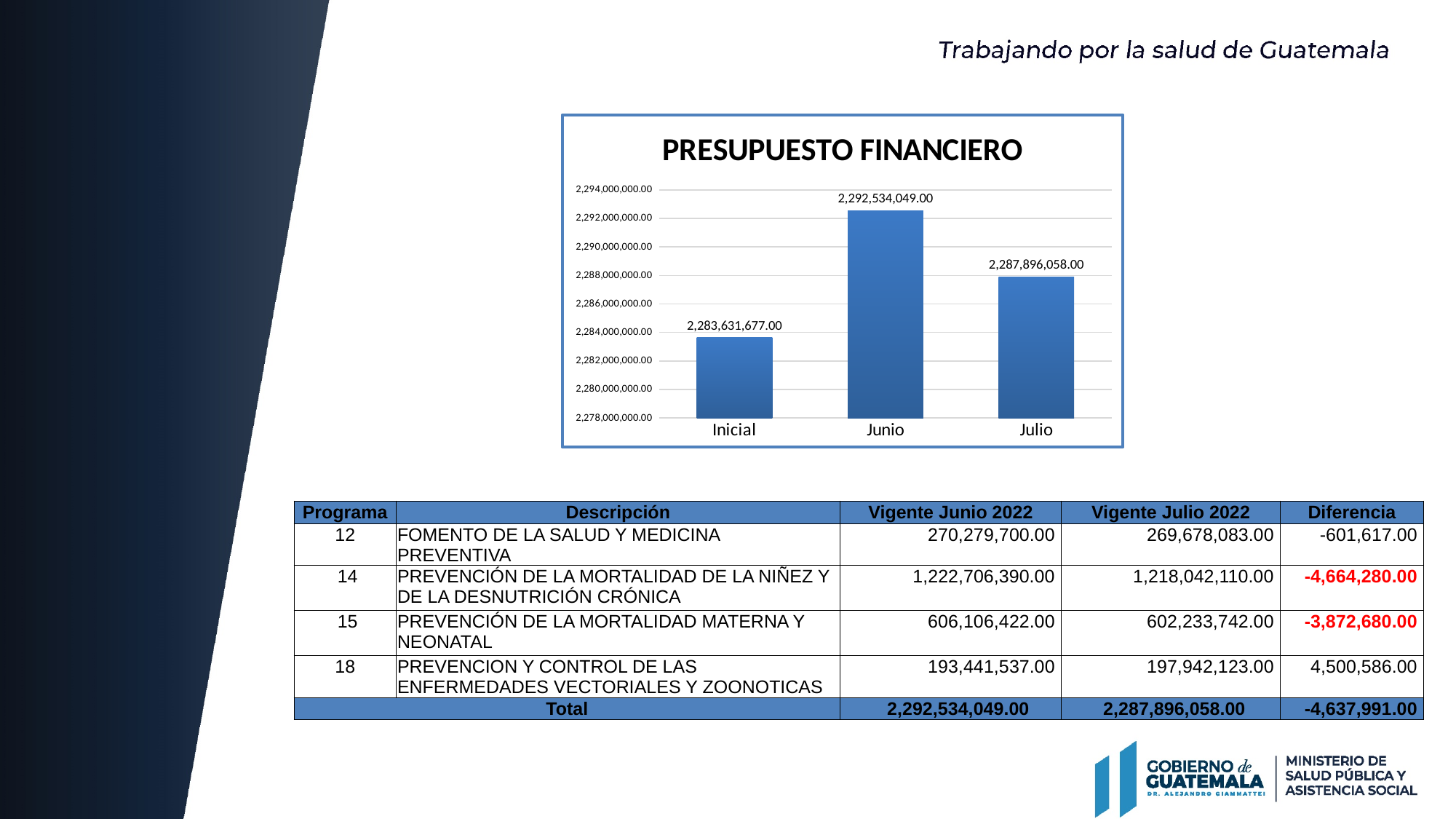
How many bars are shown in the PRESUPUESTO FINANCIERO chart? 3 In the PRESUPUESTO FINANCIERO chart, which is larger, the value for Julio or the value for Inicial? Julio What is the value for Inicial in the PRESUPUESTO FINANCIERO chart? 2,283,631,677.00 What is the difference between the Junio and Inicial values in the PRESUPUESTO FINANCIERO chart? 8,902,372.00 Which category has the lowest value in the PRESUPUESTO FINANCIERO chart? Inicial What is the value for Junio in the PRESUPUESTO FINANCIERO chart? 2,292,534,049.00 Does the value rise or fall from Junio to Julio in the PRESUPUESTO FINANCIERO chart? fall Which category has the highest value in the PRESUPUESTO FINANCIERO chart? Junio What is the value for Julio in the PRESUPUESTO FINANCIERO chart? 2,287,896,058.00 Is the value for Inicial in the PRESUPUESTO FINANCIERO chart greater or less than 2,284,000,000.00? less What kind of chart is the PRESUPUESTO FINANCIERO chart? bar chart What is the difference between the Junio and Julio values in the PRESUPUESTO FINANCIERO chart? 4,637,991.00